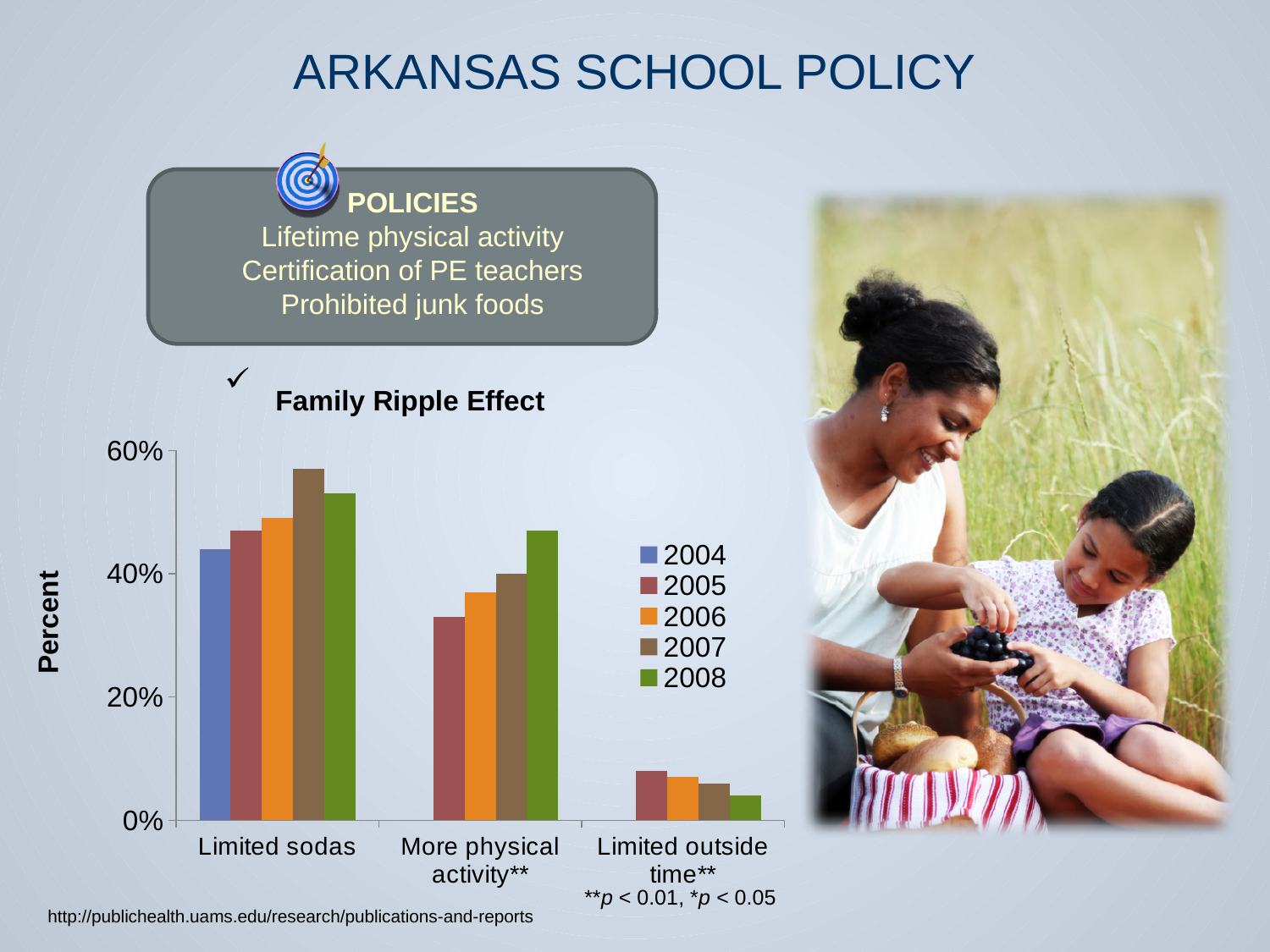
In the Family Ripple Effect chart, is the 2005 value for Limited outside time greater or less than 20%? less What is the label on the vertical axis of the Family Ripple Effect chart? Percent In the Family Ripple Effect chart, do the bars for Limited outside time rise or fall from 2005 to 2008? fall In the Family Ripple Effect chart, do the bars for More physical activity rise or fall from 2005 to 2008? rise In the Family Ripple Effect chart, which year has the highest bar for Limited sodas? 2007 What kind of chart is shown under the heading "Family Ripple Effect"? bar chart In the Family Ripple Effect chart, is the 2007 value for Limited sodas greater or less than 40%? greater In the Family Ripple Effect chart, which is larger for 2008: Limited sodas or More physical activity? Limited sodas How many series does the legend of the Family Ripple Effect chart list? 5 How many categories are shown on the x axis of the Family Ripple Effect chart? 3 In the Family Ripple Effect chart, which year has the lowest bar for Limited outside time? 2008 In the Family Ripple Effect chart, is the 2008 value for More physical activity greater or less than 40%? greater